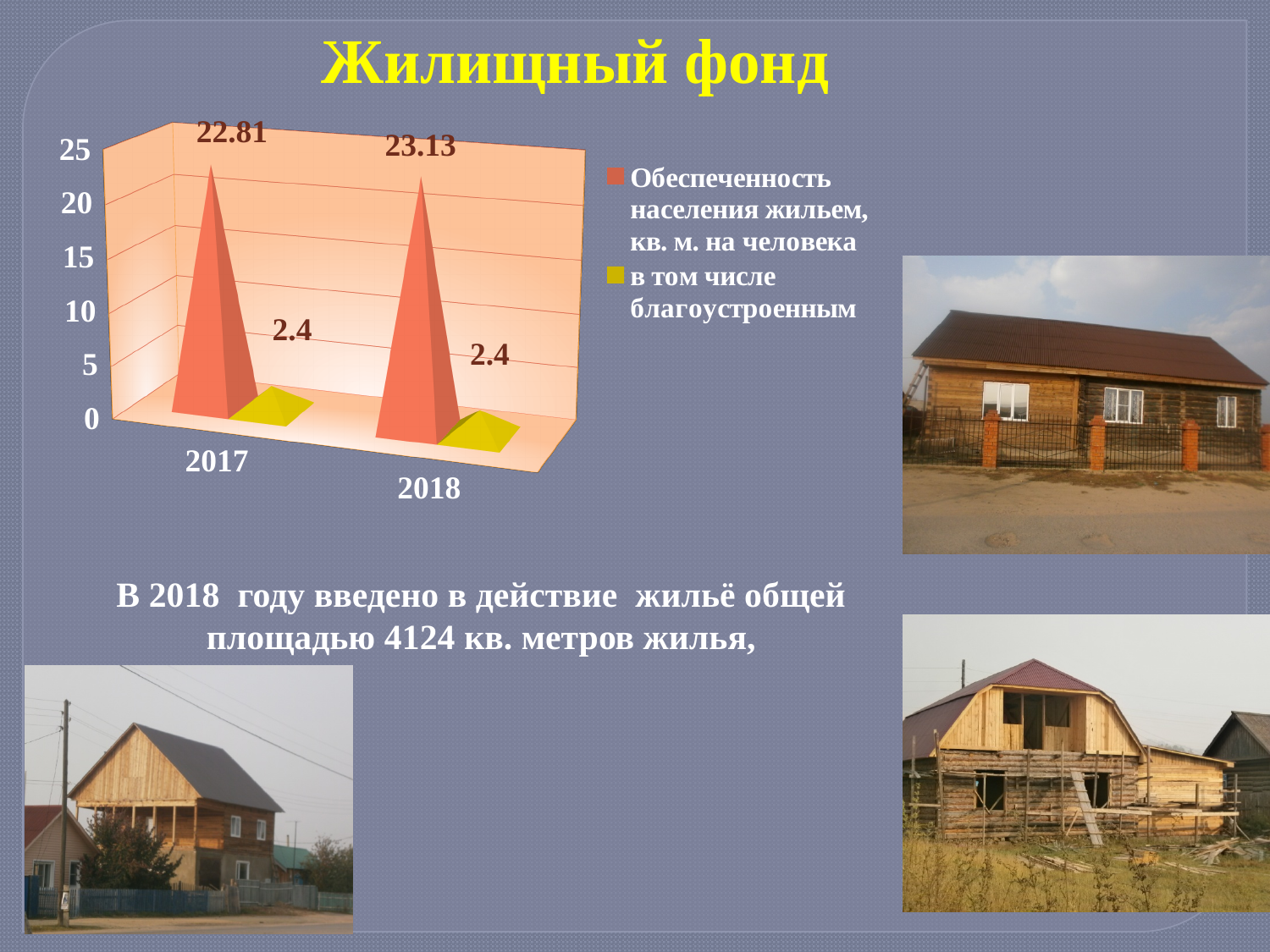
What kind of chart is shown on the slide? bar chart In which year is 'Обеспеченность населения жильем, кв. м. на человека' higher? 2018 What is the value of 'в том числе благоустроенным' for 2018? 2.4 What is the value of 'в том числе благоустроенным' for 2017? 2.4 What is the value of 'Обеспеченность населения жильем, кв. м. на человека' for 2018? 23.13 Which is larger in 2017: 'Обеспеченность населения жильем, кв. м. на человека' or 'в том числе благоустроенным'? Обеспеченность населения жильем, кв. м. на человека Does 'Обеспеченность населения жильем, кв. м. на человека' rise or fall from 2017 to 2018? rise What is the value of 'Обеспеченность населения жильем, кв. м. на человека' for 2017? 22.81 What is the difference between the 2018 and 2017 values of 'Обеспеченность населения жильем, кв. м. на человека'? 0.32 Is the 2018 value of 'Обеспеченность населения жильем, кв. м. на человека' greater or less than 20? greater How many series does the chart legend list? 2 How many years are shown on the x axis of the chart? 2